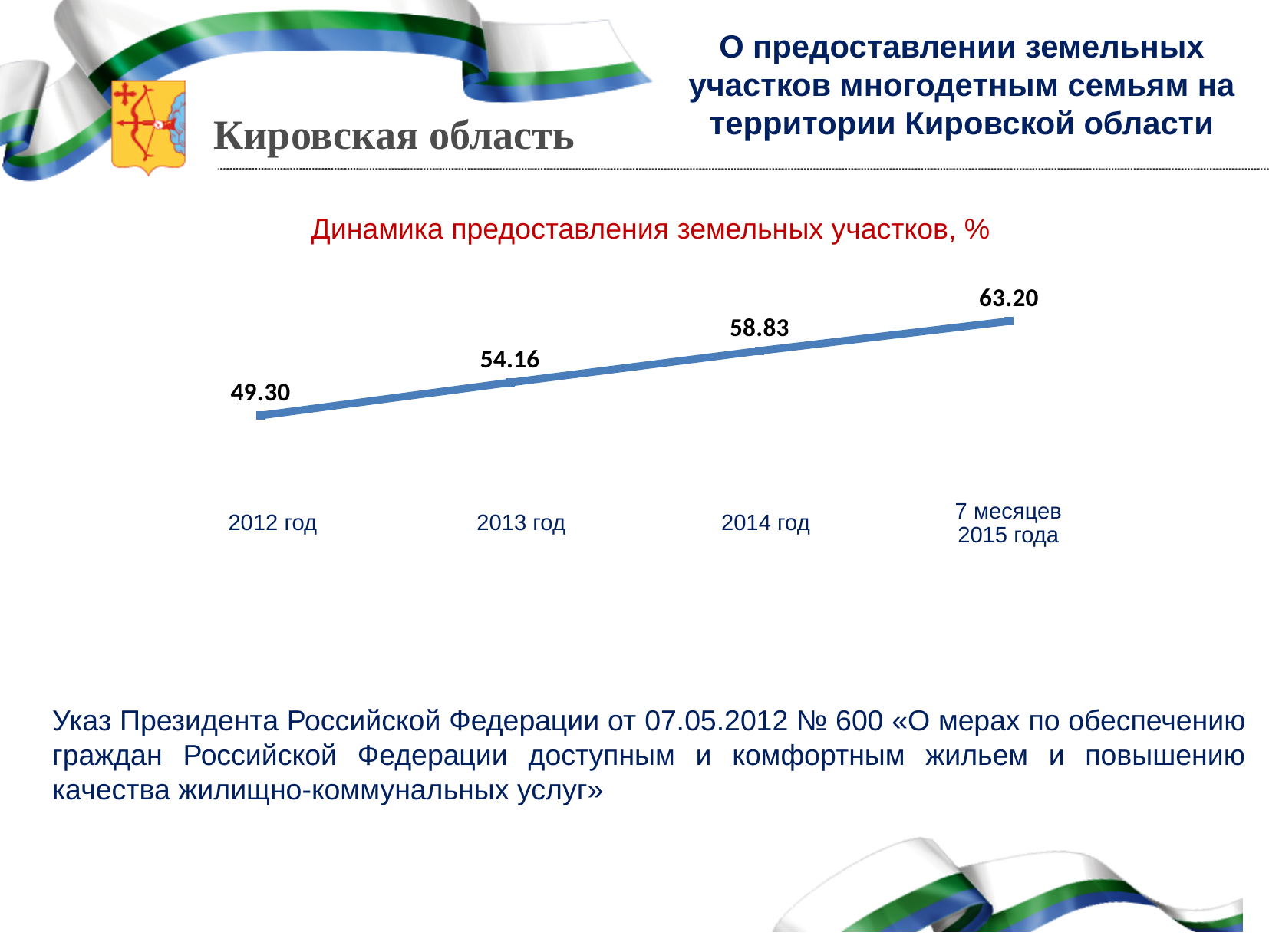
What is the value for 2014 год? 58.83 Which period has the highest value? 7 месяцев 2015 года Which period has the lowest value? 2012 год What is the value for 2012 год? 49.30 What is the difference between the values for 2014 год and 2013 год? 4.67 Do the values rise or fall from 2012 год to 7 месяцев 2015 года? rise What kind of chart is shown on the slide? line chart How many data points are plotted on the chart? 4 What is the value for 7 месяцев 2015 года? 63.20 Which is larger, the value for 2013 год or the value for 2014 год? 2014 год What is the difference between the values for 7 месяцев 2015 года and 2012 год? 13.90 What is the value for 2013 год? 54.16